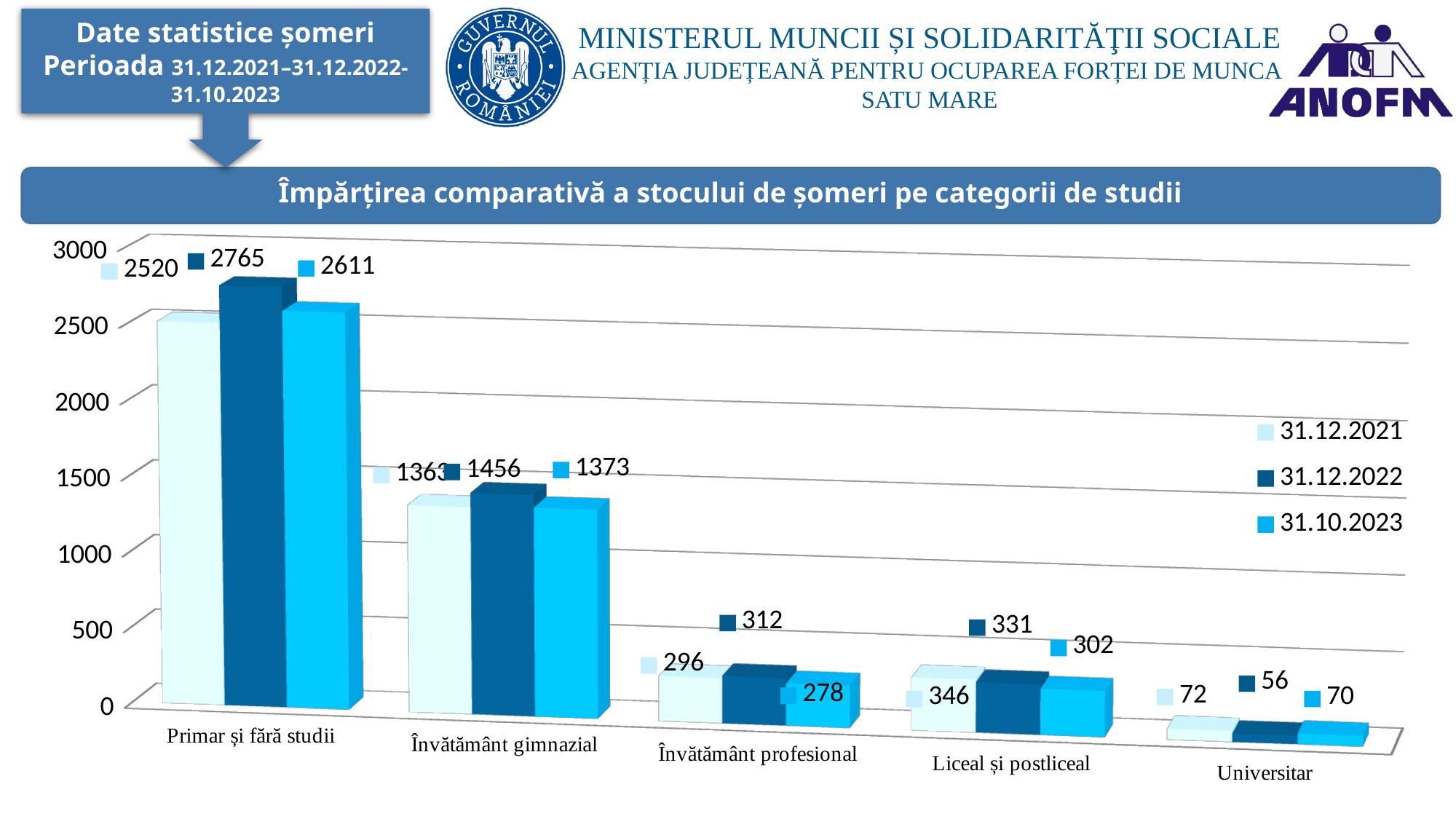
Which category has the lowest value for 31.12.2021? Universitar What is the difference between the 31.12.2022 and 31.12.2021 values for Primar și fără studii? 245 Which is larger for Învățământ profesional: the value for 31.12.2022 or for 31.10.2023? 31.12.2022 What type of chart is shown on the slide? bar chart How many series does the legend list? 3 What is the value for Universitar on 31.12.2022? 56 Which category has the highest value for 31.10.2023? Primar și fără studii What is the value for Liceal și postliceal on 31.12.2021? 346 What is the value for Învățământ gimnazial on 31.10.2023? 1373 What is the title of the chart? Împărțirea comparativă a stocului de șomeri pe categorii de studii How many education categories are shown on the x axis? 5 What is the value for Primar și fără studii on 31.12.2022? 2765